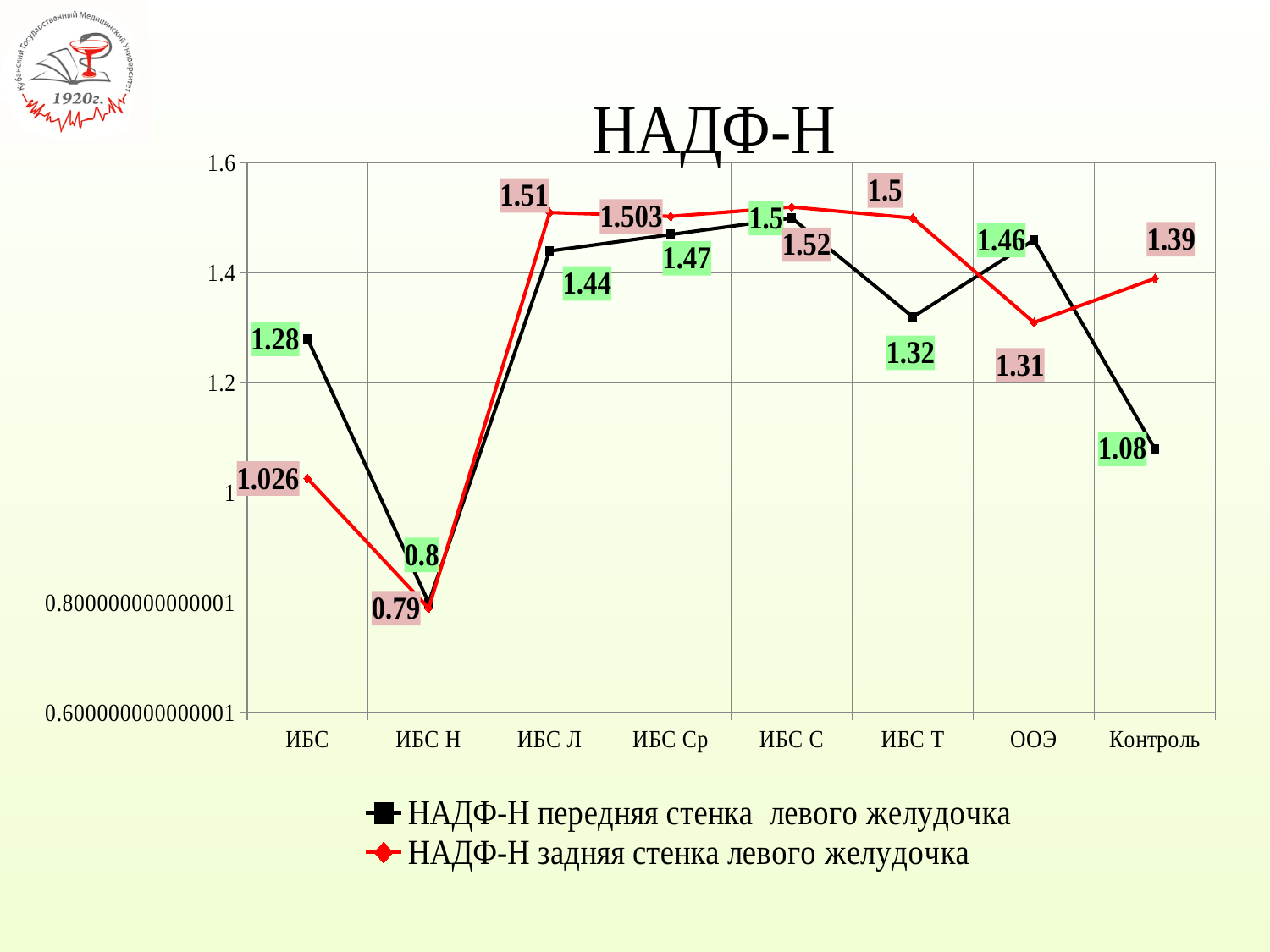
What is the value of НАДФ-Н передняя стенка левого желудочка for ИБС? 1.28 What is the difference between the передняя стенка values for ИБС Л and ИБС Н? 0.64 For which category is НАДФ-Н задняя стенка левого желудочка highest? ИБС С How many series does the legend list? 2 What is the value of НАДФ-Н задняя стенка левого желудочка for Контроль? 1.39 For ИБС Т, which series has the larger value: передняя стенка or задняя стенка? задняя стенка Does the value of НАДФ-Н передняя стенка левого желудочка rise or fall from ООЭ to Контроль? fall What is the value of НАДФ-Н задняя стенка левого желудочка for ИБС? 1.026 What kind of chart is shown on the slide? line chart How many categories are shown on the x axis? 8 For which category is НАДФ-Н передняя стенка левого желудочка lowest? ИБС Н What is the difference between the задняя стенка and передняя стенка values for Контроль? 0.31